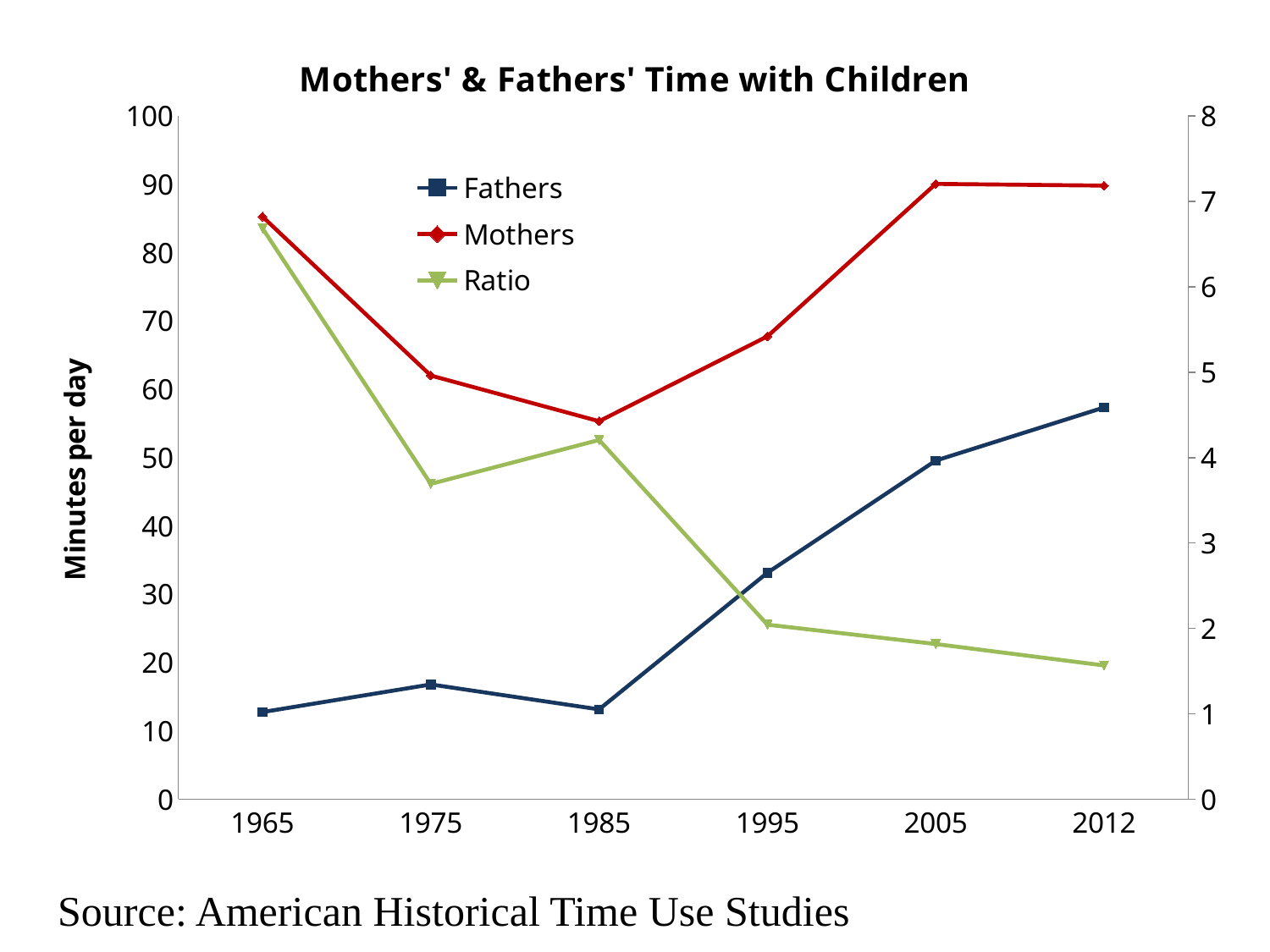
In which year is the Mothers series at its lowest? 1985 In which year is the Fathers series at its highest? 2012 Is the value for Fathers in 1995 greater or less than 30 minutes per day? greater How many series does the legend list? 3 How many years are plotted along the x axis? 6 Does the Fathers series rise or fall from 1985 to 2012? rise In which year is the Ratio series at its highest? 1965 Is the value for Mothers in 1985 greater or less than 60 minutes per day? less What kind of chart is shown on the slide? line chart Which is larger in 1975, the value for Mothers or the value for Fathers? Mothers Is the Ratio value in 2012 greater or less than 2 on the right-hand axis? less In which year is the Ratio series at its lowest? 2012